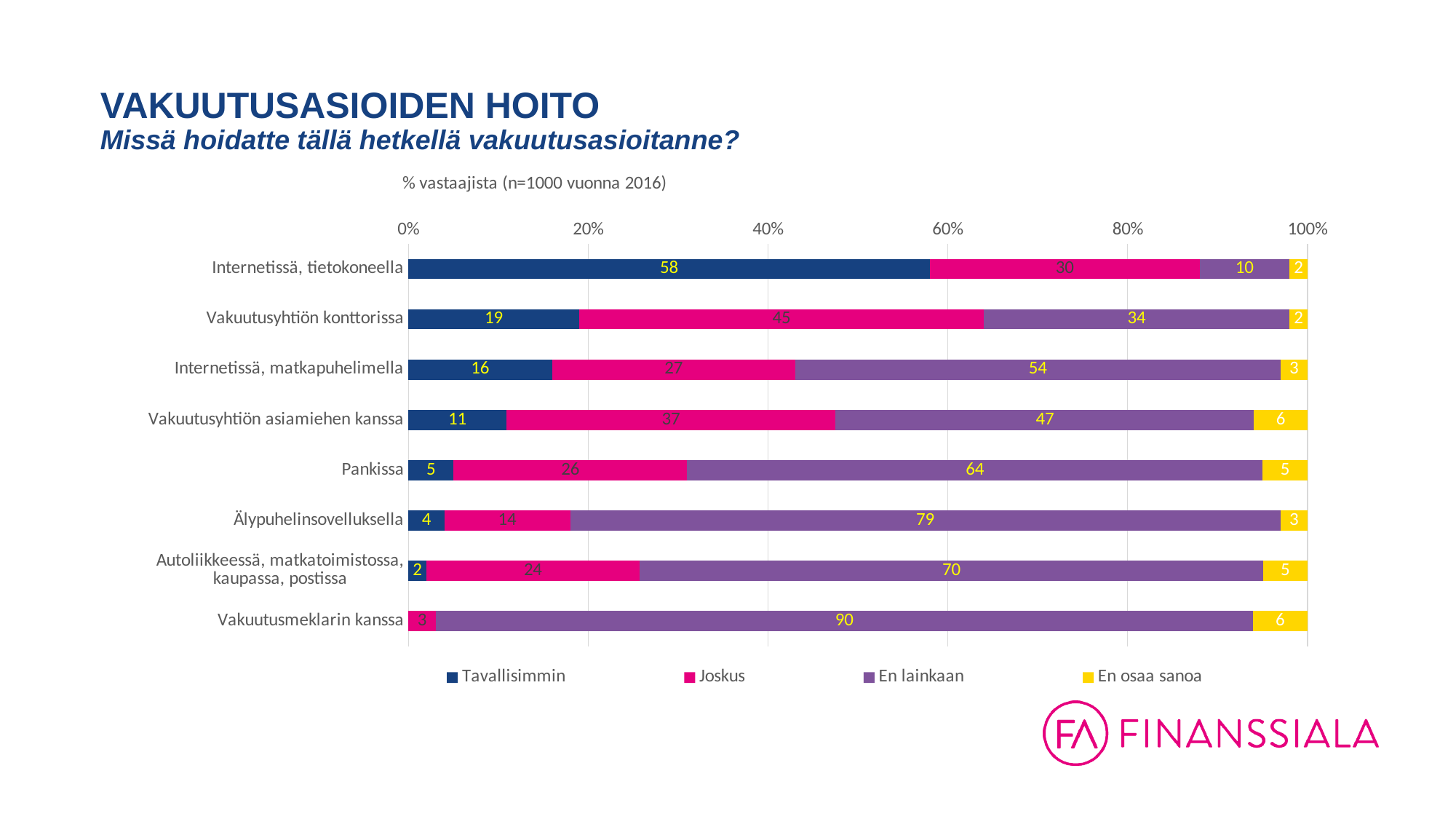
What is the total of the stacked bar for 'Vakuutusyhtiön konttorissa'? 100 Which is larger: the 'Joskus' value for 'Internetissä, matkapuhelimella' or for 'Pankissa'? Internetissä, matkapuhelimella Which category has the lowest 'En lainkaan' value? Internetissä, tietokoneella Which category has the highest 'Tavallisimmin' value? Internetissä, tietokoneella What is the difference between the 'En lainkaan' values for 'Älypuhelinsovelluksella' and 'Pankissa'? 15 How many series does the legend list? 4 What is the 'En osaa sanoa' value for 'Vakuutusyhtiön asiamiehen kanssa'? 6 What is the 'Tavallisimmin' value for 'Internetissä, tietokoneella'? 58 What is the 'En lainkaan' value for 'Vakuutusmeklarin kanssa'? 90 How many categories (places for handling insurance matters) are listed on the chart? 8 What kind of chart is shown on the slide? Stacked bar chart What is the 'Joskus' value for 'Vakuutusyhtiön konttorissa'? 45